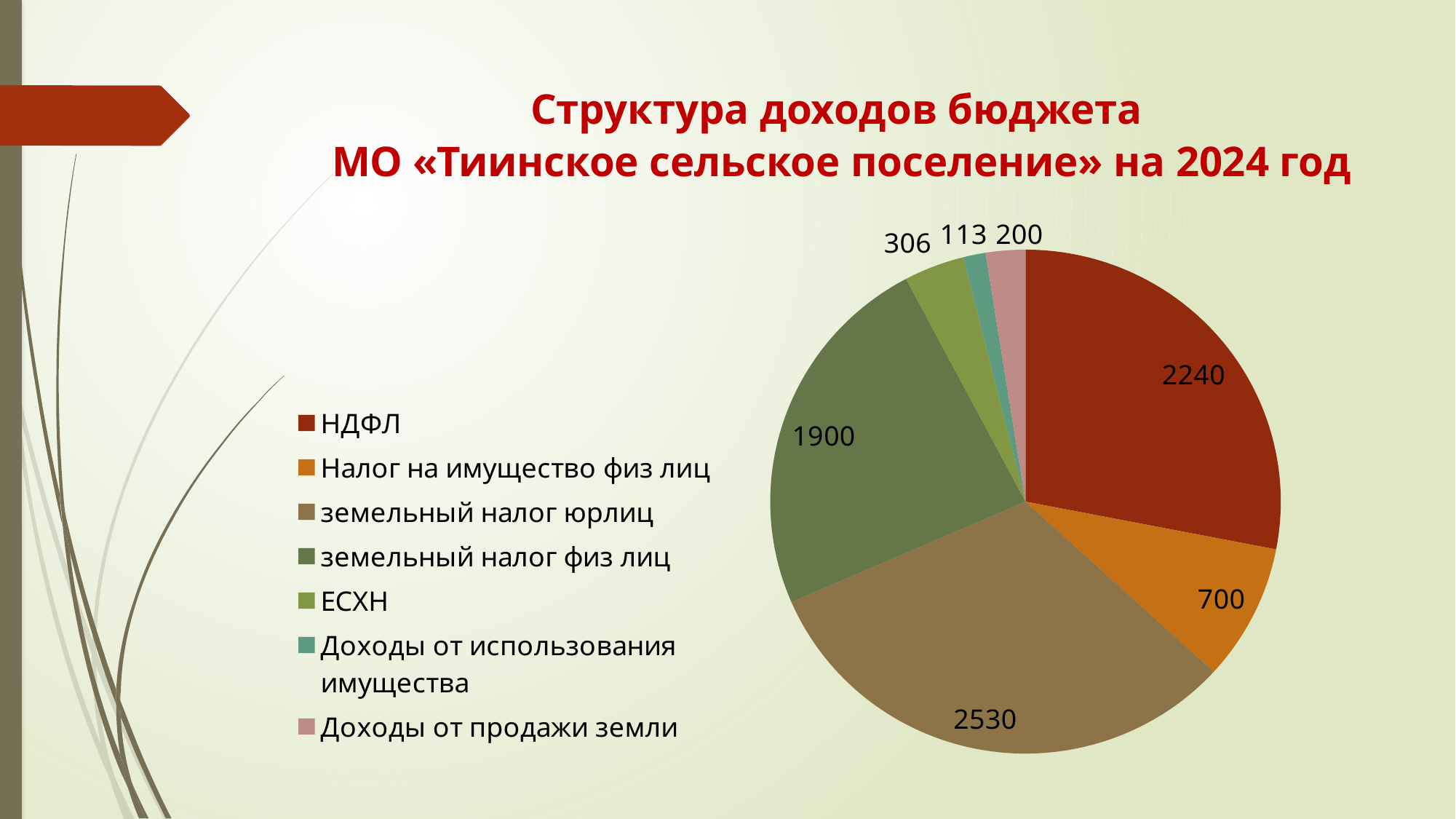
Which category has the smallest slice of the pie? Доходы от использования имущества How many categories does the pie chart have? 7 What is the value for земельный налог юрлиц? 2530 What is the total of all the values shown in the pie chart? 7989 Which is larger, the value for земельный налог физ лиц or the value for Налог на имущество физ лиц? земельный налог физ лиц What is the value for Доходы от использования имущества? 113 What kind of chart is shown on the slide? pie chart What is the difference between the values for земельный налог юрлиц and НДФЛ? 290 What is the value for НДФЛ? 2240 What is the value for ЕСХН? 306 What is the title of the slide containing the chart? Структура доходов бюджета МО «Тиинское сельское поселение» на 2024 год Which category has the largest slice of the pie? земельный налог юрлиц